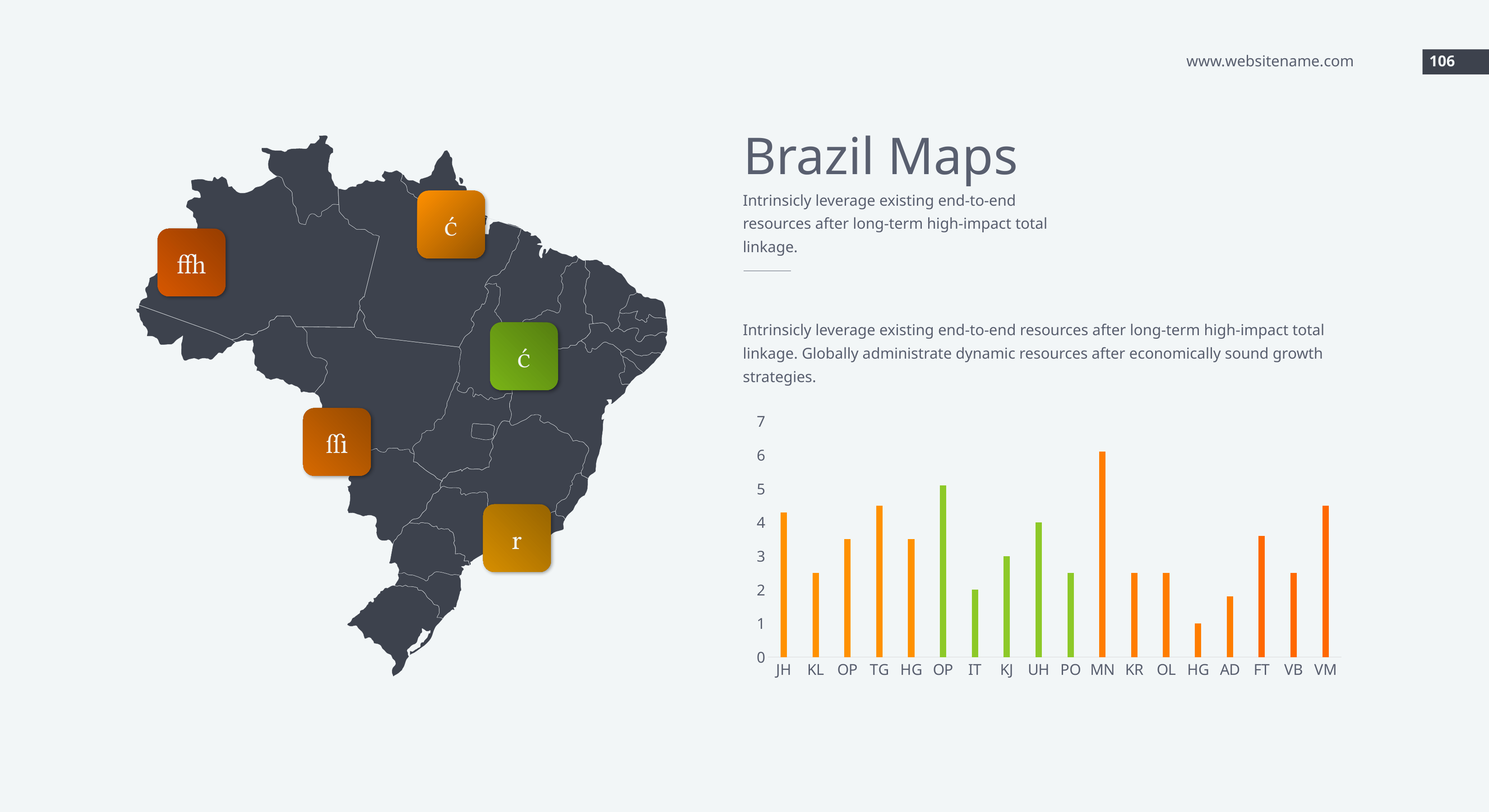
Which category has the highest bar in the chart? MN How many categories are shown on the x axis of the bar chart? 18 Which is larger, the value for FT or the value for AD? FT Which is larger, the value for MN or the value for JH? MN Is the value for JH greater or less than 4? greater What kind of chart is shown on the slide? bar chart What two colours are used for the bars in the chart? orange and green Is the value for MN greater or less than 5? greater Which is larger, the value for UH or the value for IT? UH Is the value for VM greater or less than 4? greater